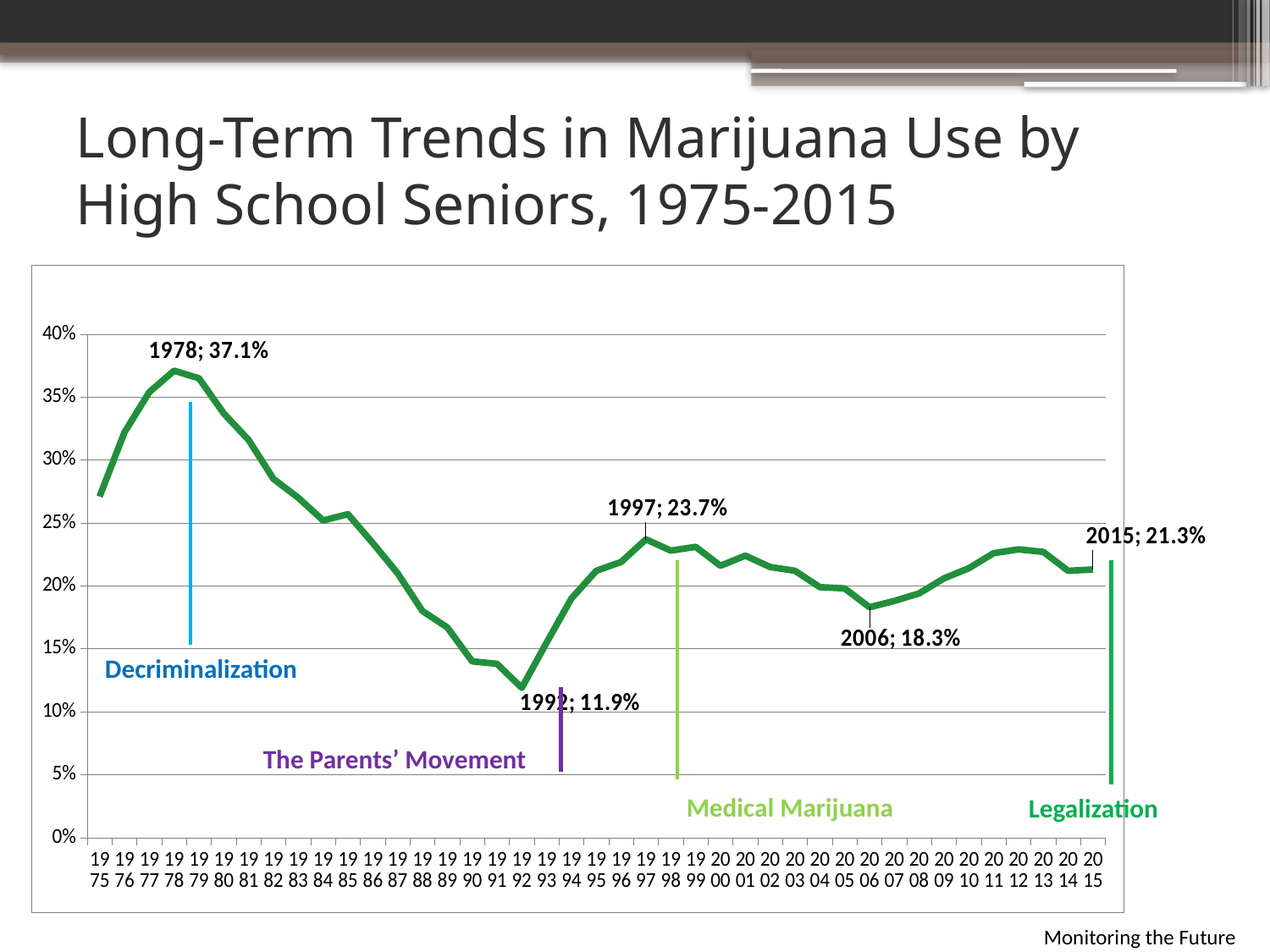
What was the marijuana use rate among high school seniors in 1978? 37.1% Which year has the highest value on the chart? 1978 What is the difference between the 1978 value and the 1992 value? 25.2% What value is labeled for 2015? 21.3% Which is larger, the value for 1997 or the value for 2015? 1997 Which event label is placed near 1978 on the chart? Decriminalization What value is labeled for 1992? 11.9% What kind of chart is shown on the slide? line chart What value is labeled for 2006? 18.3% Which year has the lowest value on the chart? 1992 What value is labeled for 1997? 23.7% Is the value for 1975 greater or less than 25%? greater